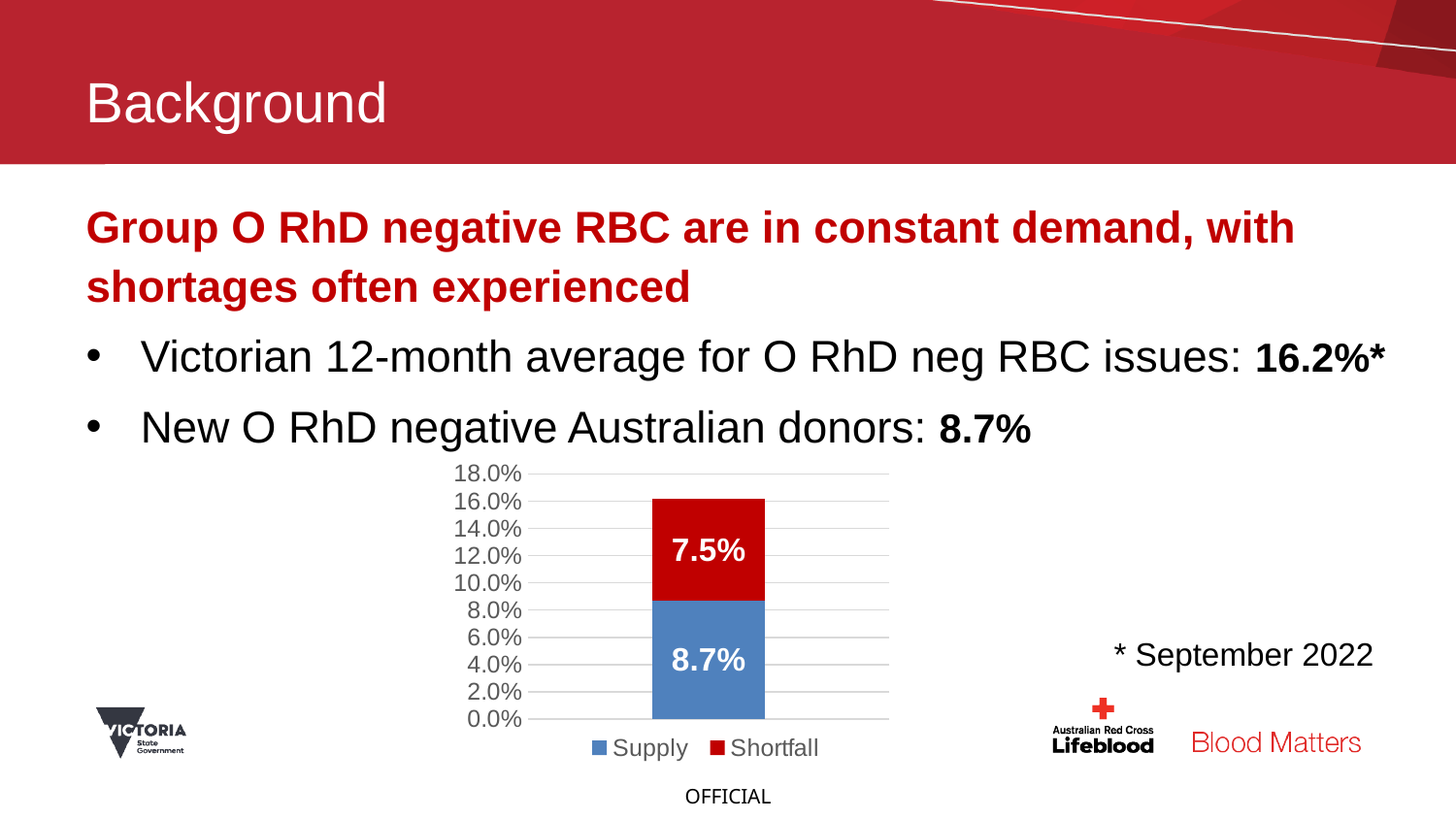
What is the value of the Supply segment in the stacked bar? 8.7% Which segment is larger, Supply or Shortfall? Supply What kind of chart is shown on the slide? Stacked bar chart Which series has the highest value in the chart? Supply What colour represents the Shortfall series in the chart? Red Is the top of the stacked bar greater or less than 14.0%? greater How many series does the legend list? 2 Which series has the lowest value in the chart? Shortfall What is the difference between the Supply and Shortfall values? 1.2% What is the total of the stacked bar (Supply plus Shortfall)? 16.2% What is the maximum value shown on the vertical axis? 18.0% What is the value of the Shortfall segment in the stacked bar? 7.5%